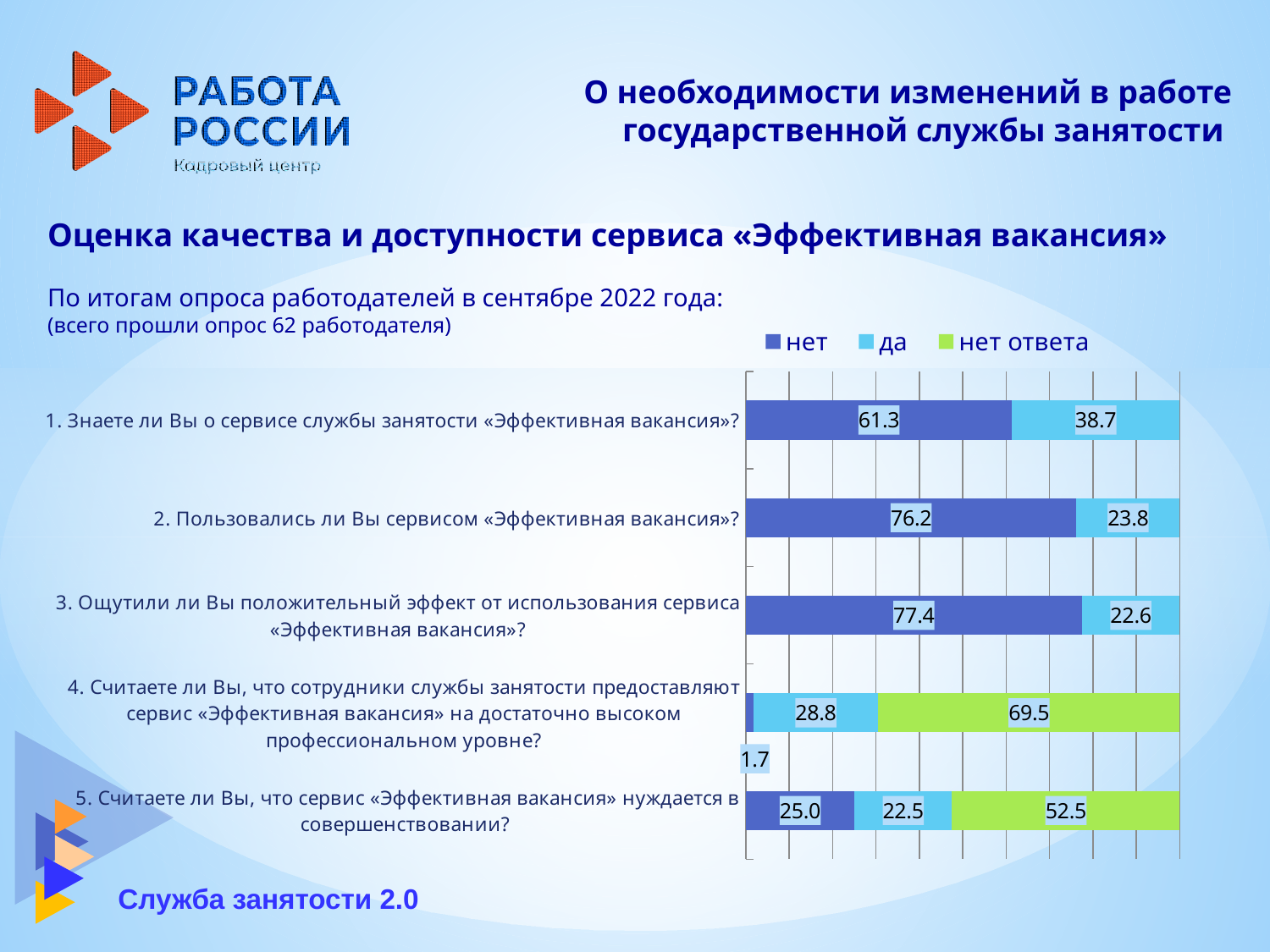
What kind of chart is shown on the slide? Stacked bar chart What is the value of «нет» for question 5 («Считаете ли Вы, что сервис «Эффективная вакансия» нуждается в совершенствовании?»)? 25.0 What is the total of the stacked bar for question 4 (нет + да + нет ответа)? 100.0 How many survey questions (categories) are plotted in the chart? 5 Which survey question has the highest «нет» value? 3. Ощутили ли Вы положительный эффект от использования сервиса «Эффективная вакансия»? What is the value of «да» for question 2 («Пользовались ли Вы сервисом «Эффективная вакансия»?»)? 23.8 For question 5, which is larger: the «нет» value or the «да» value? нет What is the value of «нет» for question 1 («Знаете ли Вы о сервисе службы занятости «Эффективная вакансия»?»)? 61.3 How many series does the chart legend list? 3 What is the difference between the «нет» and «да» values for question 1? 22.6 What is the value of «нет ответа» for question 4 about the professional level of employment service staff? 69.5 Which survey question has the lowest «нет» value? 4. Считаете ли Вы, что сотрудники службы занятости предоставляют сервис «Эффективная вакансия» на достаточно высоком профессиональном уровне?